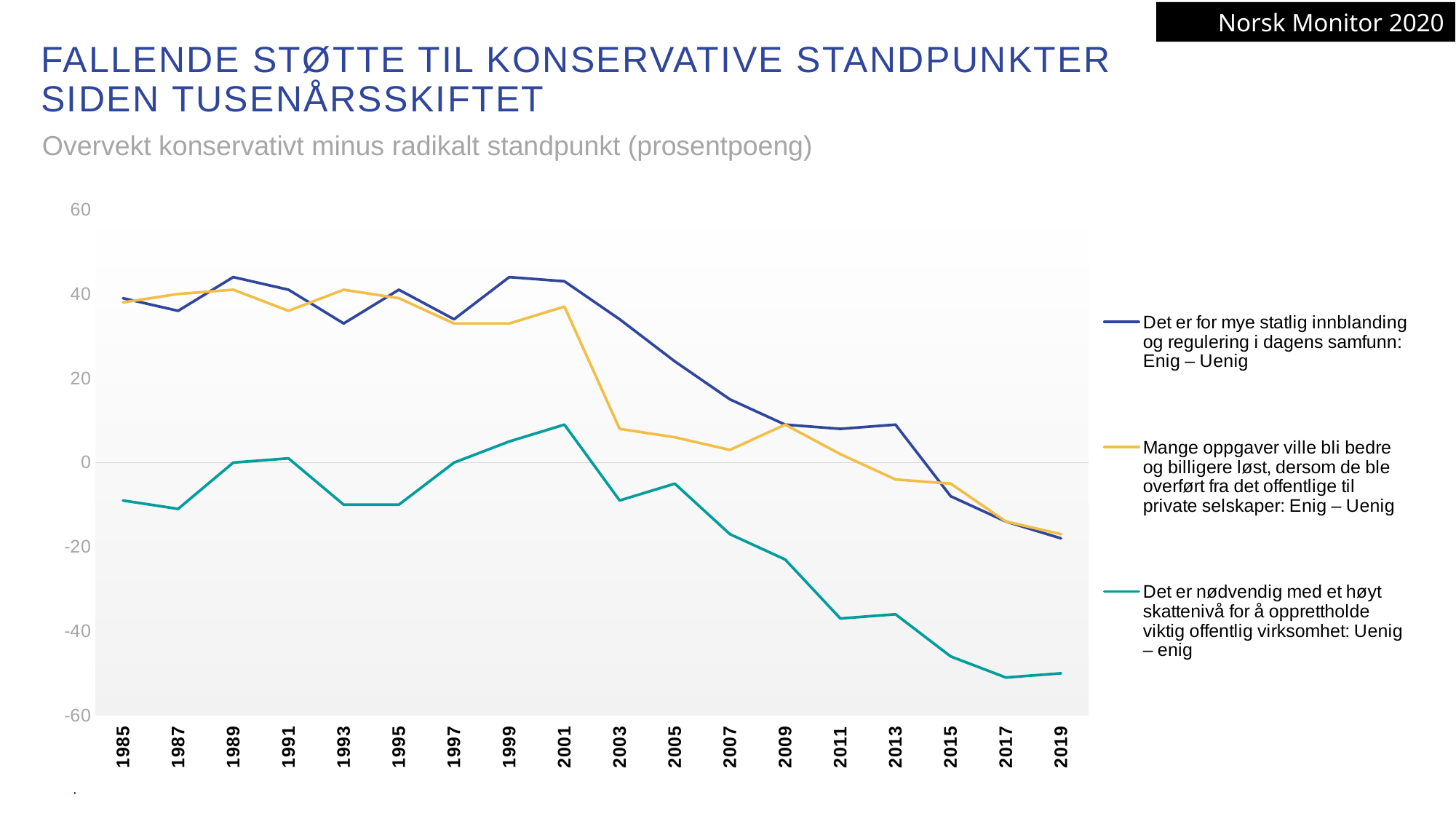
What is the subtitle describing the measure plotted in the chart? Overvekt konservativt minus radikalt standpunkt (prosentpoeng) Does the line for "Det er nødvendig med et høyt skattenivå for å opprettholde viktig offentlig virksomhet: Uenig – enig" rise or fall from 2001 to 2019? Fall Is the 2003 value for "Mange oppgaver ville bli bedre og billigere løst, dersom de ble overført fra det offentlige til private selskaper: Enig – Uenig" greater or less than 20? less In 2019, which series has the higher value: "Det er for mye statlig innblanding og regulering i dagens samfunn: Enig – Uenig" or "Det er nødvendig med et høyt skattenivå for å opprettholde viktig offentlig virksomhet: Uenig – enig"? Det er for mye statlig innblanding og regulering i dagens samfunn: Enig – Uenig How many series does the legend list? 3 Which series has the lowest value in 2017? Det er nødvendig med et høyt skattenivå for å opprettholde viktig offentlig virksomhet: Uenig – enig Is the 1999 value for "Det er for mye statlig innblanding og regulering i dagens samfunn: Enig – Uenig" greater or less than 40? greater Is the 2019 value for "Det er nødvendig med et høyt skattenivå for å opprettholde viktig offentlig virksomhet: Uenig – enig" greater or less than -40? less What kind of chart is shown on the slide? Line chart Which series has the highest value in 1999? Det er for mye statlig innblanding og regulering i dagens samfunn: Enig – Uenig How many years are labelled along the x axis? 18